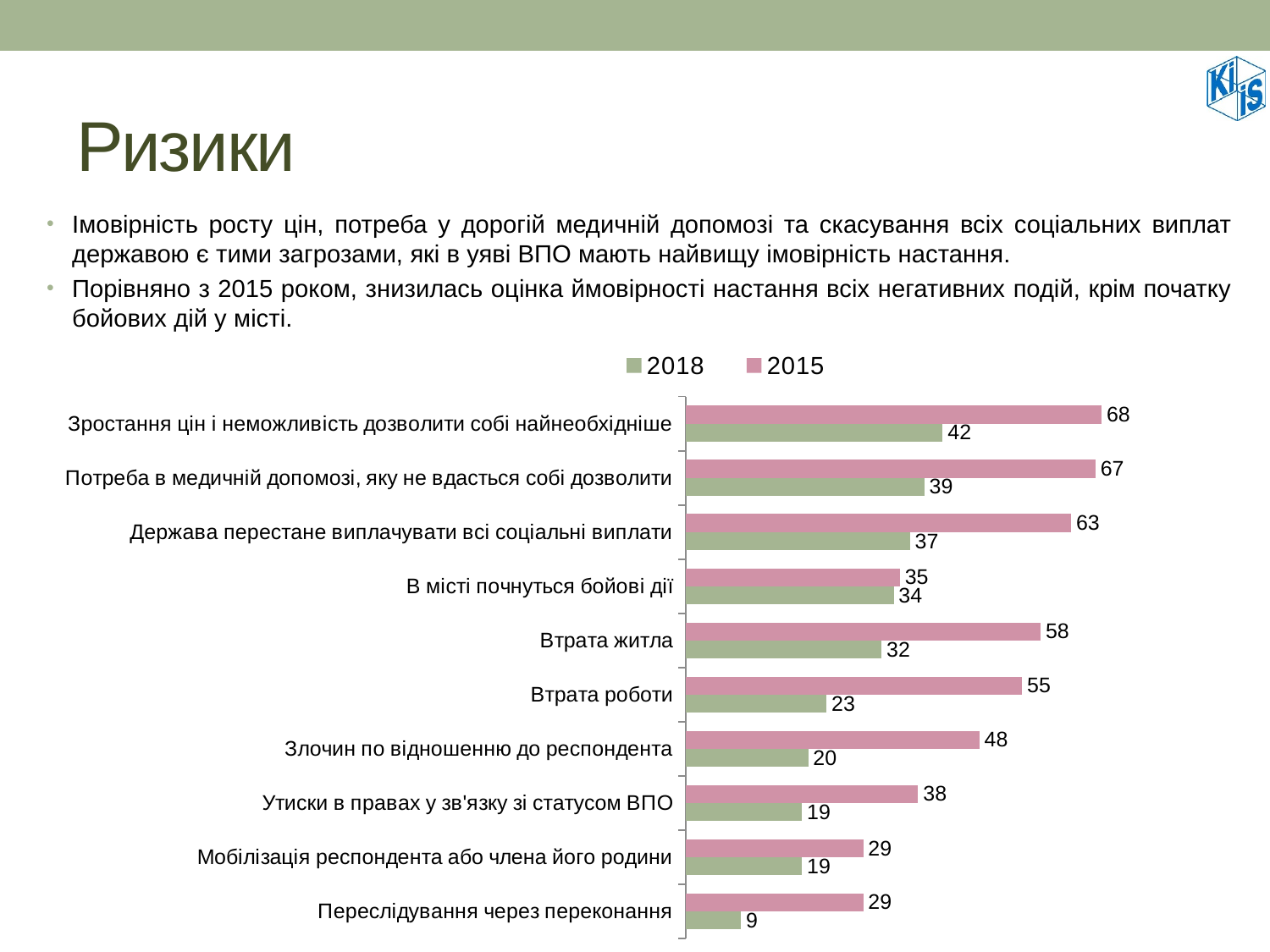
What is the 2015 value for "Мобілізація респондента або члена його родини"? 29 Which is larger: the 2015 value for "Злочин по відношенню до респондента" or the 2015 value for "Утиски в правах у зв'язку зі статусом ВПО"? Злочин по відношенню до респондента What is the 2015 value for "Зростання цін і неможливість дозволити собі найнеобхідніше"? 68 How many series does the legend list? 2 Which category has the highest 2018 value? Зростання цін і неможливість дозволити собі найнеобхідніше Which category has the lowest 2018 value? Переслідування через переконання What is the 2018 value for "Втрата роботи"? 23 How many categories are shown in the chart? 10 What is the 2018 value for "Переслідування через переконання"? 9 Which series is shown in pink in the legend? 2015 What is the difference between the 2015 and 2018 values for "Втрата житла"? 26 What kind of chart is shown on the slide? Bar chart